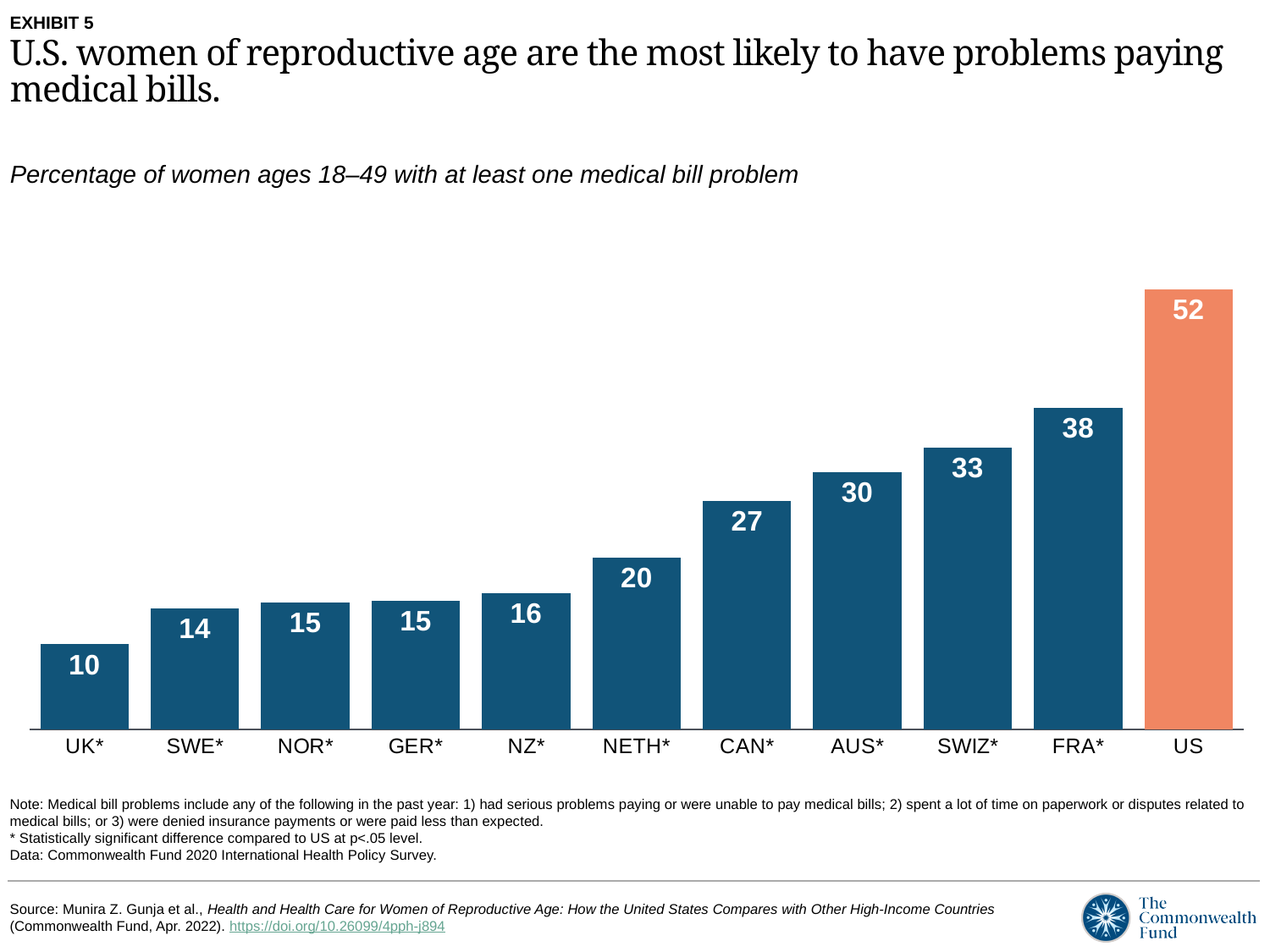
What is the value for NETH*? 20 Do the values rise or fall from left to right along the x axis? Rise Which bar is shown in a different colour from the others? US What is the difference between the values for the US and FRA*? 14 What kind of chart is this? Bar chart Which country has the lowest value? UK* What is the difference between the values for CAN* and UK*? 17 Which is larger, the value for AUS* or the value for NZ*? AUS* What is the value for SWIZ*? 33 What is the value for the US? 52 Which country has the highest value? US How many countries are shown in the chart? 11